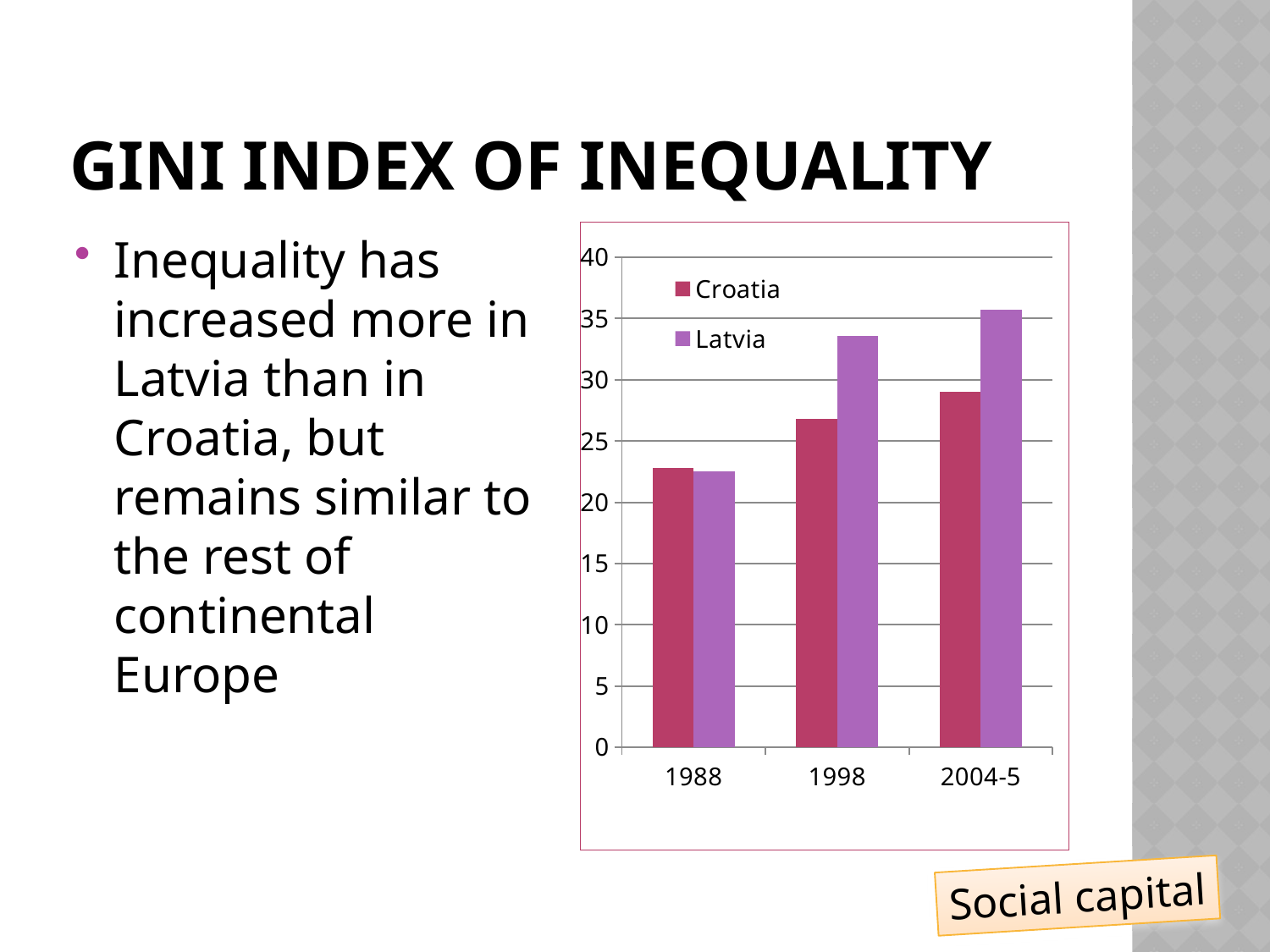
Do the values for Croatia rise or fall from 1988 to 2004-5? rise Is the value for Latvia in 2004-5 greater or less than 35? greater Is the value for Croatia in 2004-5 greater or less than 30? less Which colour represents Latvia in the chart? purple How many series does the chart's legend list? 2 Is the value for Croatia in 1998 greater or less than 25? greater How many categories are shown on the x axis of the chart? 3 In 1998, which is larger, the value for Croatia or the value for Latvia? Latvia Which two series are listed in the chart's legend? Croatia and Latvia In 2004-5, which is larger, the value for Croatia or the value for Latvia? Latvia Do the values for Latvia rise or fall from 1988 to 2004-5? rise What kind of chart is shown on the slide? bar chart